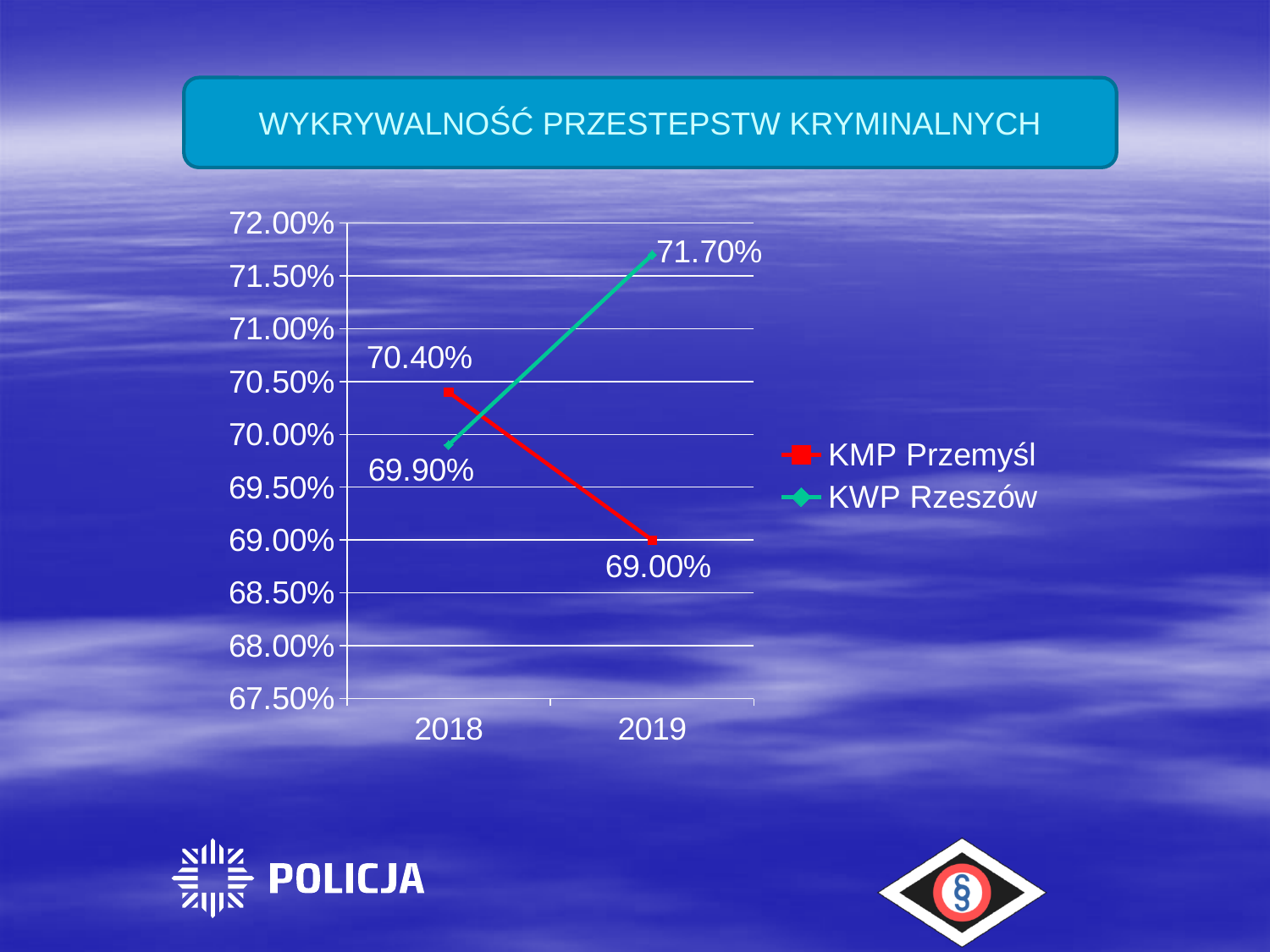
What is the value for KWP Rzeszów in 2018? 69.90% Which series has the higher value in 2019? KWP Rzeszów What is the difference between the KWP Rzeszów value in 2019 and the KMP Przemyśl value in 2019? 2.70% By how much did the KMP Przemyśl value change from 2018 to 2019? 1.40% What is the value for KMP Przemyśl in 2019? 69.00% How many series does the legend list? 2 Does the KMP Przemyśl series rise or fall from 2018 to 2019? fall What kind of chart is shown on the slide? line chart Which series has the higher value in 2018? KMP Przemyśl What is the value for KMP Przemyśl in 2018? 70.40% What is the value for KWP Rzeszów in 2019? 71.70% Does the KWP Rzeszów series rise or fall from 2018 to 2019? rise